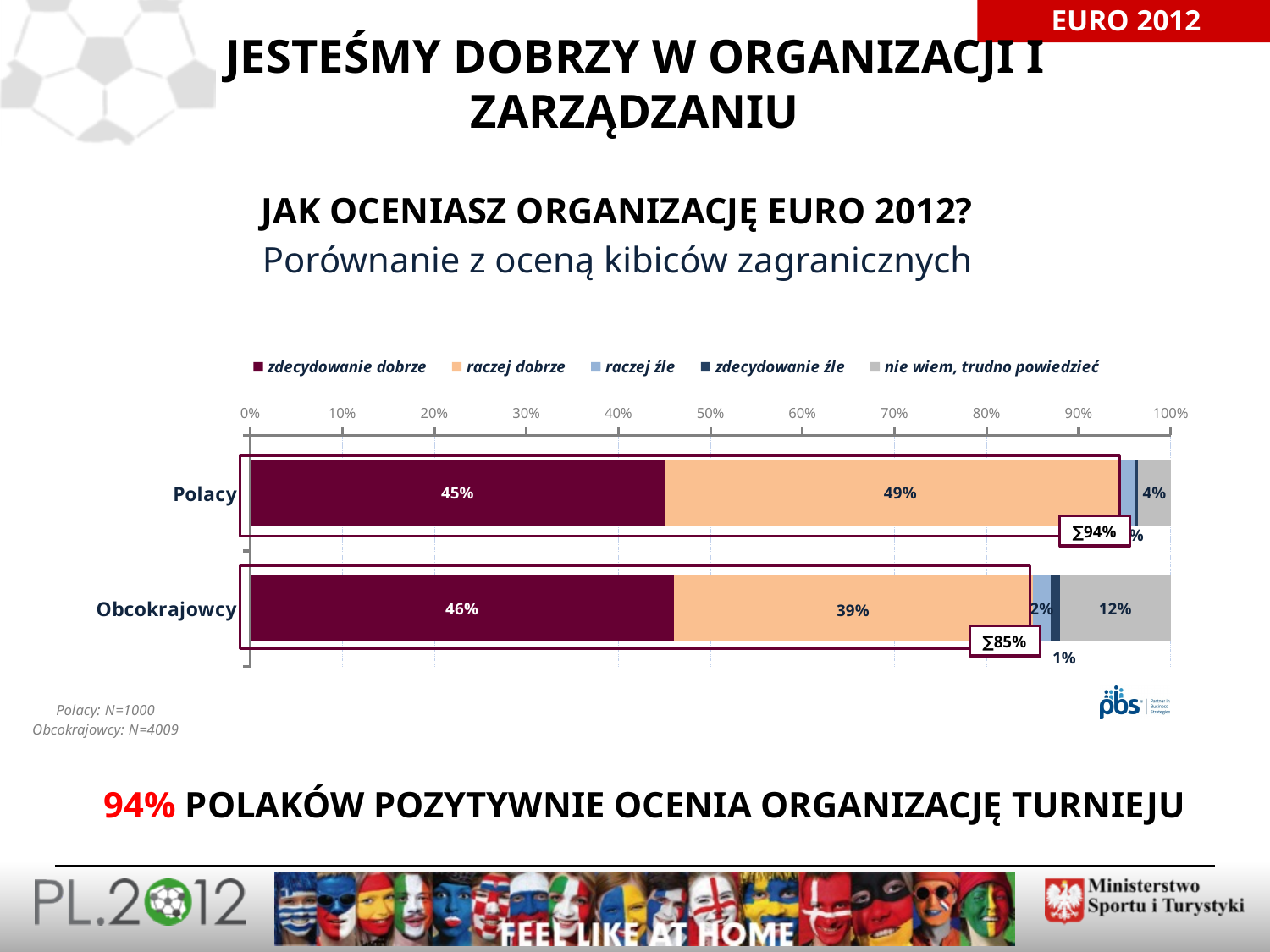
How many series does the chart legend list? 5 What is the value of 'raczej dobrze' for Obcokrajowcy? 39% What is the value of 'zdecydowanie dobrze' for Obcokrajowcy? 46% What combined positive share (∑) is annotated for Polacy? ∑94% What is the value of 'zdecydowanie dobrze' for Polacy? 45% What is the value of 'nie wiem, trudno powiedzieć' for Polacy? 4% What kind of chart is shown on the slide? Stacked bar chart What combined positive share (∑) is annotated for Obcokrajowcy? ∑85% What is the value of 'nie wiem, trudno powiedzieć' for Obcokrajowcy? 12% What is the difference between the 'raczej dobrze' values for Polacy and Obcokrajowcy? 10 percentage points What is the value of 'raczej dobrze' for Polacy? 49% How many respondent groups (categories) are plotted in the chart? 2